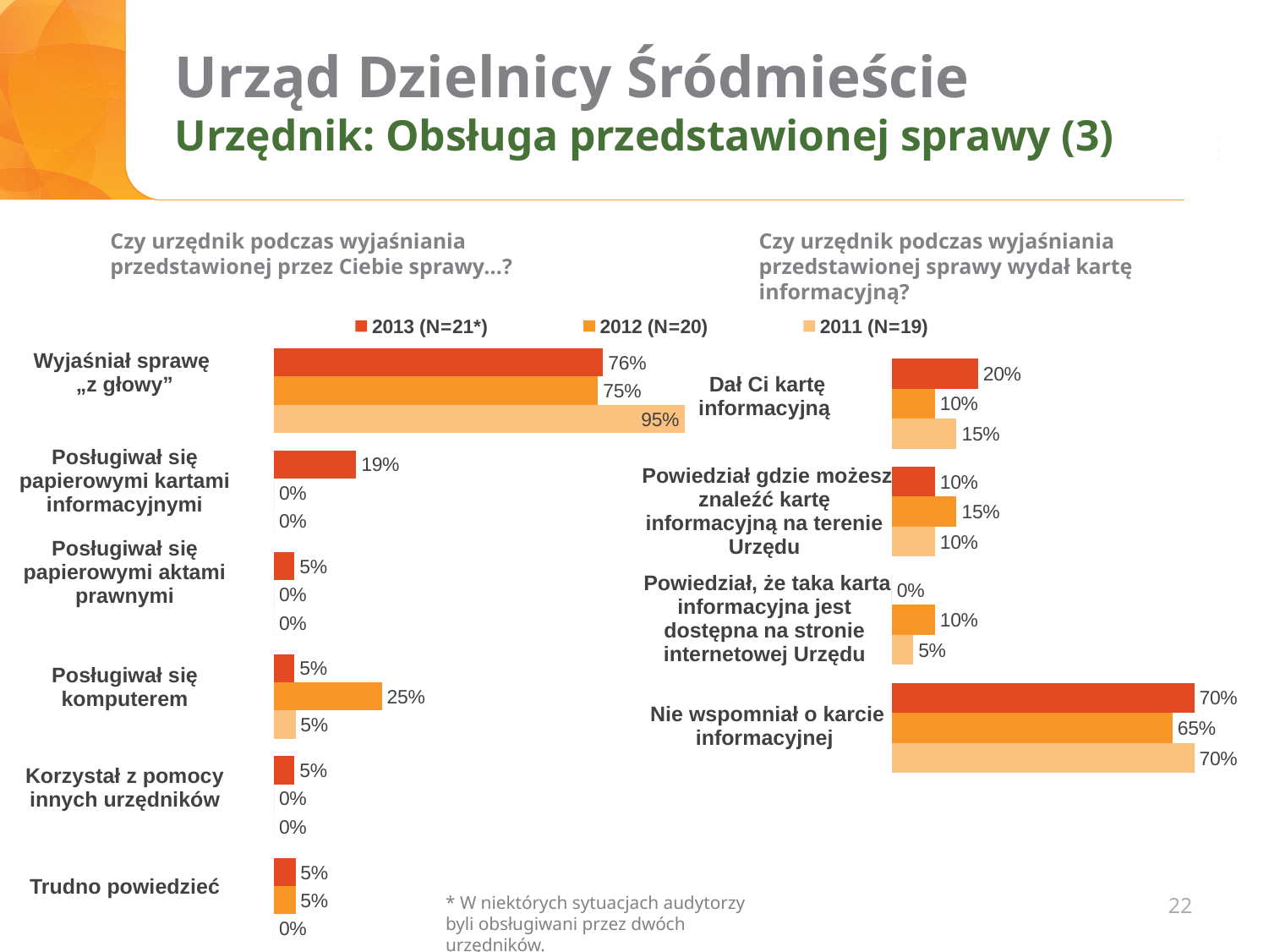
In the right chart, which category has the lowest 2013 value? Powiedział, że taka karta informacyjna jest dostępna na stronie internetowej Urzędu In the right chart, what is the 2013 value for "Dał Ci kartę informacyjną"? 20% In the left chart, what is the difference between the 2011 and 2013 values for "Wyjaśniał sprawę „z głowy”"? 19 percentage points In the right chart ("Czy urzędnik podczas wyjaśniania przedstawionej sprawy wydał kartę informacyjną?"), what is the 2012 value for "Nie wspomniał o karcie informacyjnej"? 65% What type of chart is used on this slide? Bar chart In the left chart, what is the 2013 value for "Posługiwał się papierowymi kartami informacyjnymi"? 19% In the right chart, is the 2012 value for "Powiedział gdzie możesz znaleźć kartę informacyjną na terenie Urzędu" larger or smaller than the 2013 value for the same category? larger In the left chart, which category has the highest 2013 value? Wyjaśniał sprawę „z głowy” How many series does the legend list? 3 In the left chart, what is the 2012 value for "Posługiwał się komputerem"? 25% In the left chart, how many categories are shown? 6 In the left chart ("Czy urzędnik podczas wyjaśniania przedstawionej przez Ciebie sprawy...?"), what is the 2011 value for "Wyjaśniał sprawę „z głowy”"? 95%